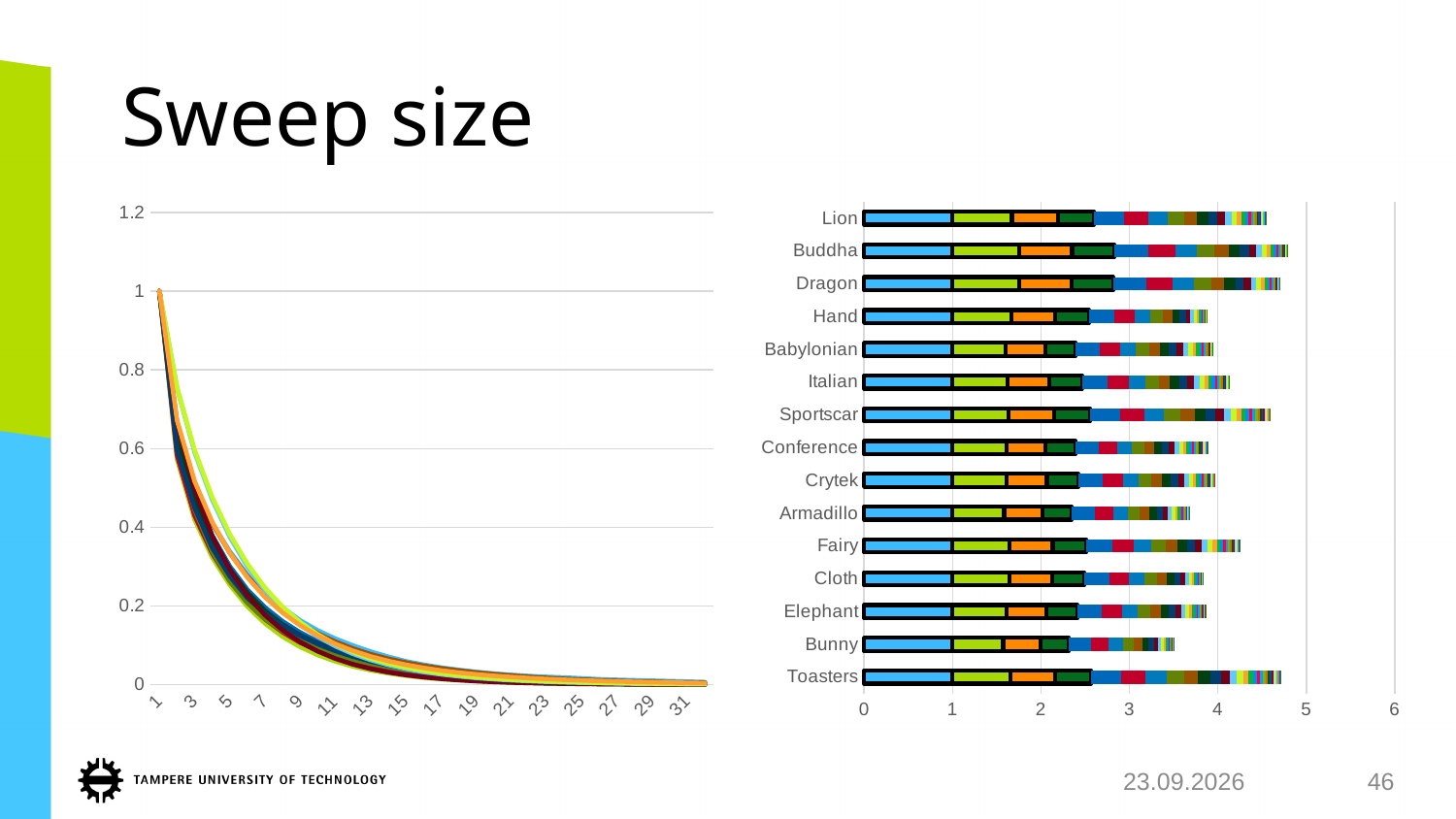
In the bar chart on the right, which has the longer total bar, Lion or Hand? Lion In the bar chart on the right, is the total bar for Bunny greater or less than 4? less What kind of chart is the chart on the right of the slide? bar chart How many categories are listed on the vertical axis of the bar chart on the right? 15 In the line chart on the left, do the values rise or fall as the x axis increases? fall In the line chart on the left, what value do the lines start at when x is 1? 1 In the line chart on the left, are the values at x = 11 greater or less than 0.2? less In the bar chart on the right, is the total bar for Armadillo greater or less than 3? greater In the bar chart on the right, which category has the shortest total bar? Bunny What kind of chart is the chart on the left of the slide? line chart In the bar chart on the right, which has the longer total bar, Buddha or Bunny? Buddha